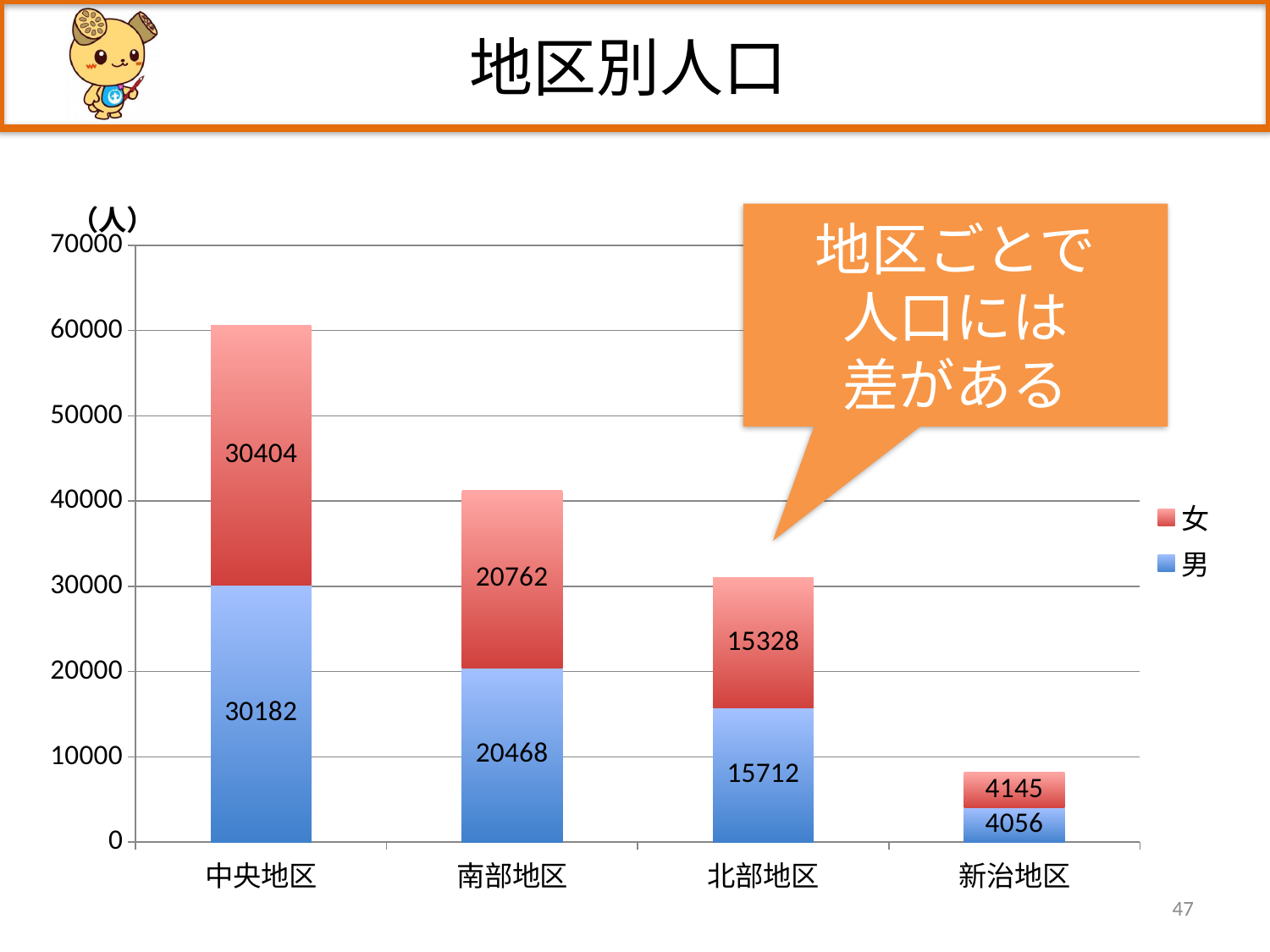
What is the difference between 女 and 男 in 中央地区? 222 What kind of chart is shown on the slide? stacked bar chart What is the value for 女 in 南部地区? 20762 What is the total population of 北部地区 (男 plus 女)? 31040 How many series does the legend list? 2 What is the value for 男 in 北部地区? 15712 Which district has the lowest total population? 新治地区 What is the value for 男 in 中央地区? 30182 Which district has the highest total population? 中央地区 How many districts are shown on the x axis? 4 What is the total population of 南部地区 (男 plus 女)? 41230 What is the value for 女 in 新治地区? 4145